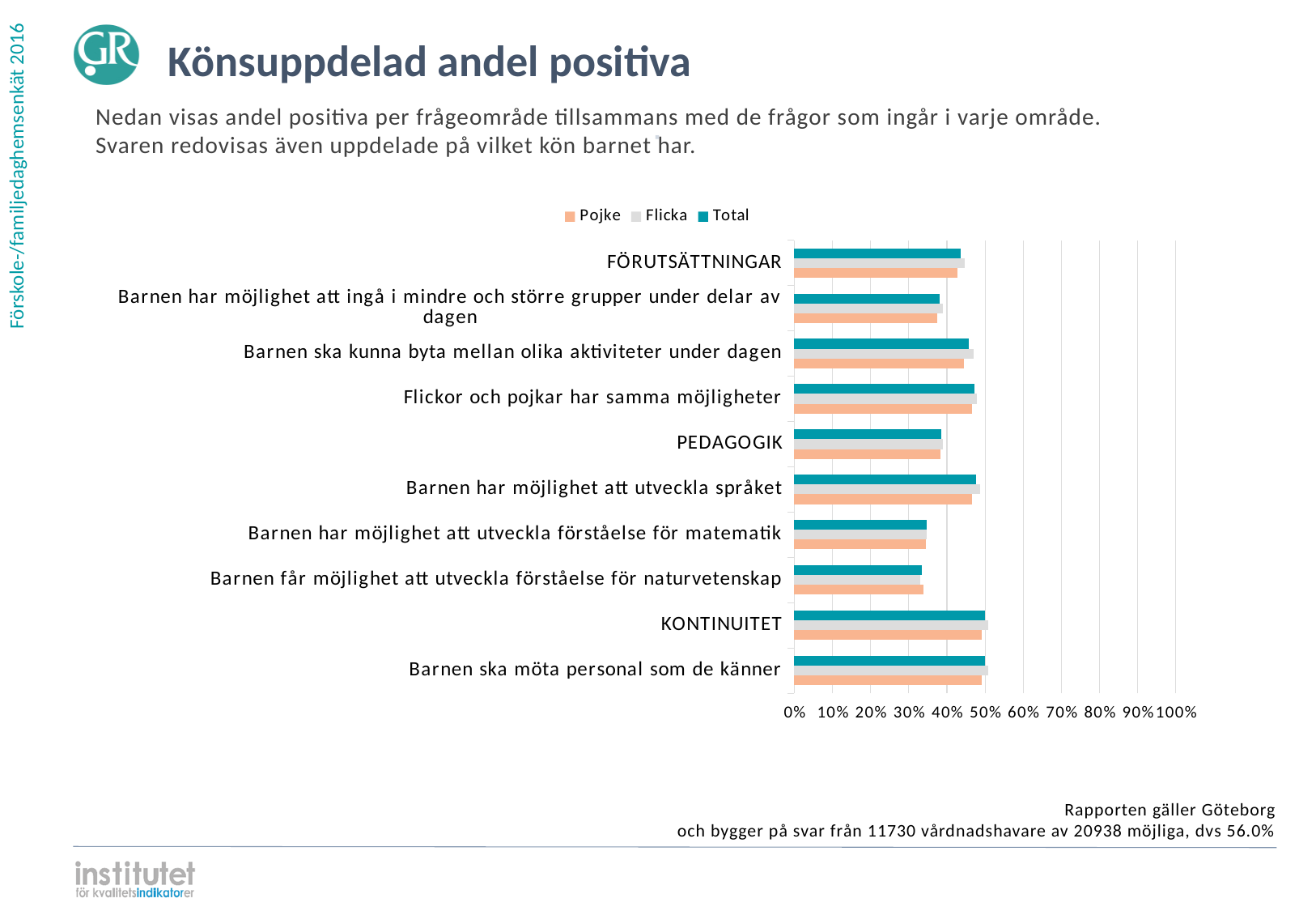
What are the names of the series listed in the chart legend? Pojke, Flicka, Total Is the Total value for 'KONTINUITET' greater or less than 40%? greater Is the Total value for 'Barnen har möjlighet att utveckla förståelse för matematik' greater or less than 40%? less How many series does the chart legend list? 3 Which has a higher Total value: 'Barnen ska kunna byta mellan olika aktiviteter under dagen' or 'Barnen får möjlighet att utveckla förståelse för naturvetenskap'? Barnen ska kunna byta mellan olika aktiviteter under dagen Is the Total value for 'Barnen får möjlighet att utveckla förståelse för naturvetenskap' greater or less than 40%? less What is the title of the slide containing the chart? Könsuppdelad andel positiva Which has a higher Total value: 'Flickor och pojkar har samma möjligheter' or 'Barnen har möjlighet att utveckla förståelse för matematik'? Flickor och pojkar har samma möjligheter What kind of chart is shown on the slide? bar chart How many categories are plotted on the chart? 10